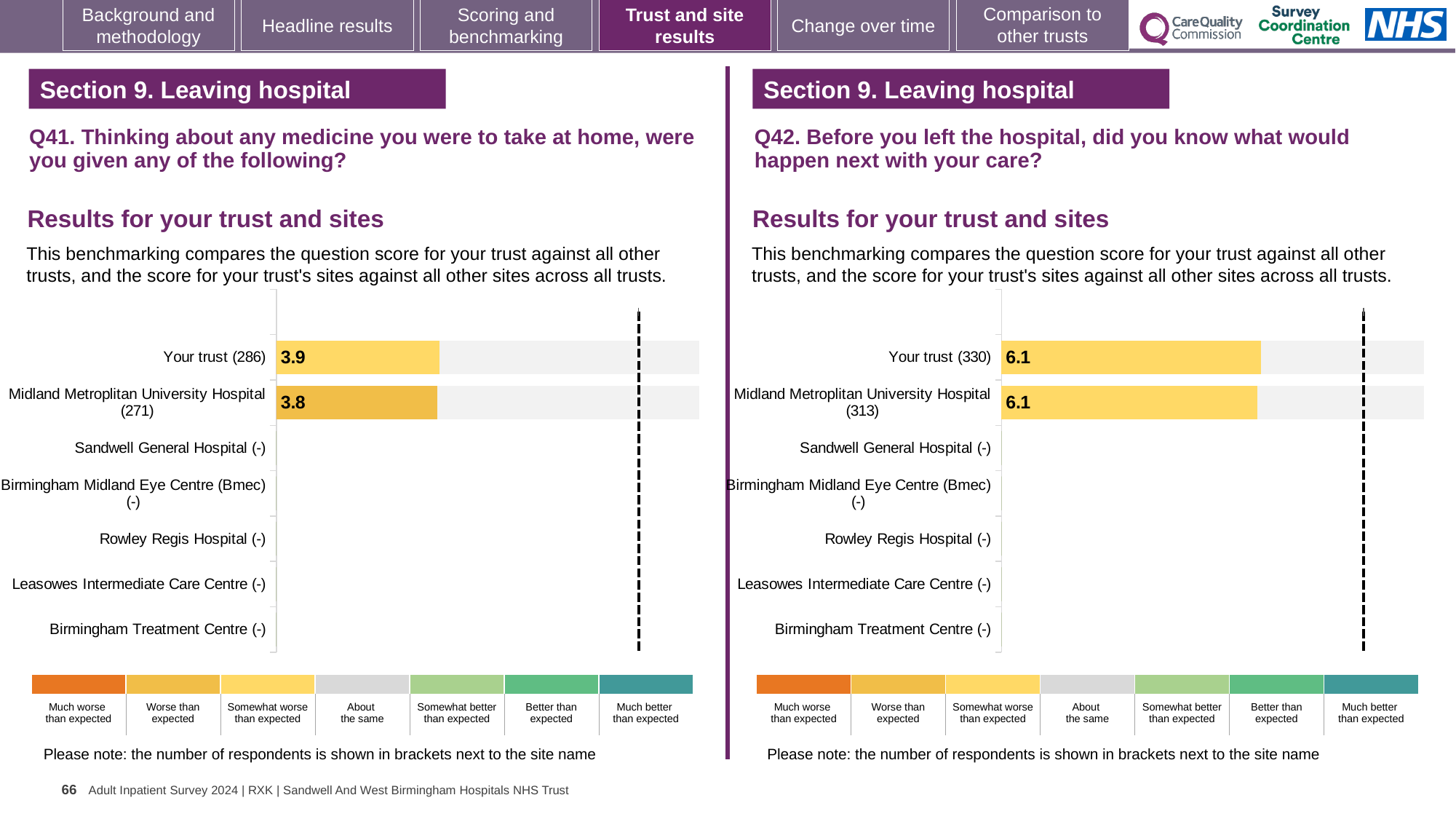
In the Q41 chart on the left, what is the difference between the score for Your trust and the score for Midland Metropolitan University Hospital? 0.1 How many respondents are shown in brackets for Your trust in the Q42 chart on the right? 330 In the Q41 chart on the left, which has the higher score: Your trust or Midland Metropolitan University Hospital? Your trust How many respondents are shown in brackets for Midland Metropolitan University Hospital in the Q41 chart on the left? 271 In the Q42 chart on the right, what is the score for Midland Metropolitan University Hospital? 6.1 How many site/trust categories are listed on the y axis of the Q41 chart on the left? 7 In the Q41 chart on the left, what is the score for Your trust? 3.9 In the Q41 chart on the left, which benchmark category does the colour of the Midland Metropolitan University Hospital bar correspond to in the legend? Worse than expected In the Q42 chart on the right, what is the score for Your trust? 6.1 In the Q41 chart on the left, what is the score for Midland Metropolitan University Hospital? 3.8 What kind of chart is used for the Q42 results on the right? Bar chart In the Q42 chart on the right, what is the difference between the score for Your trust and the score for Midland Metropolitan University Hospital? 0